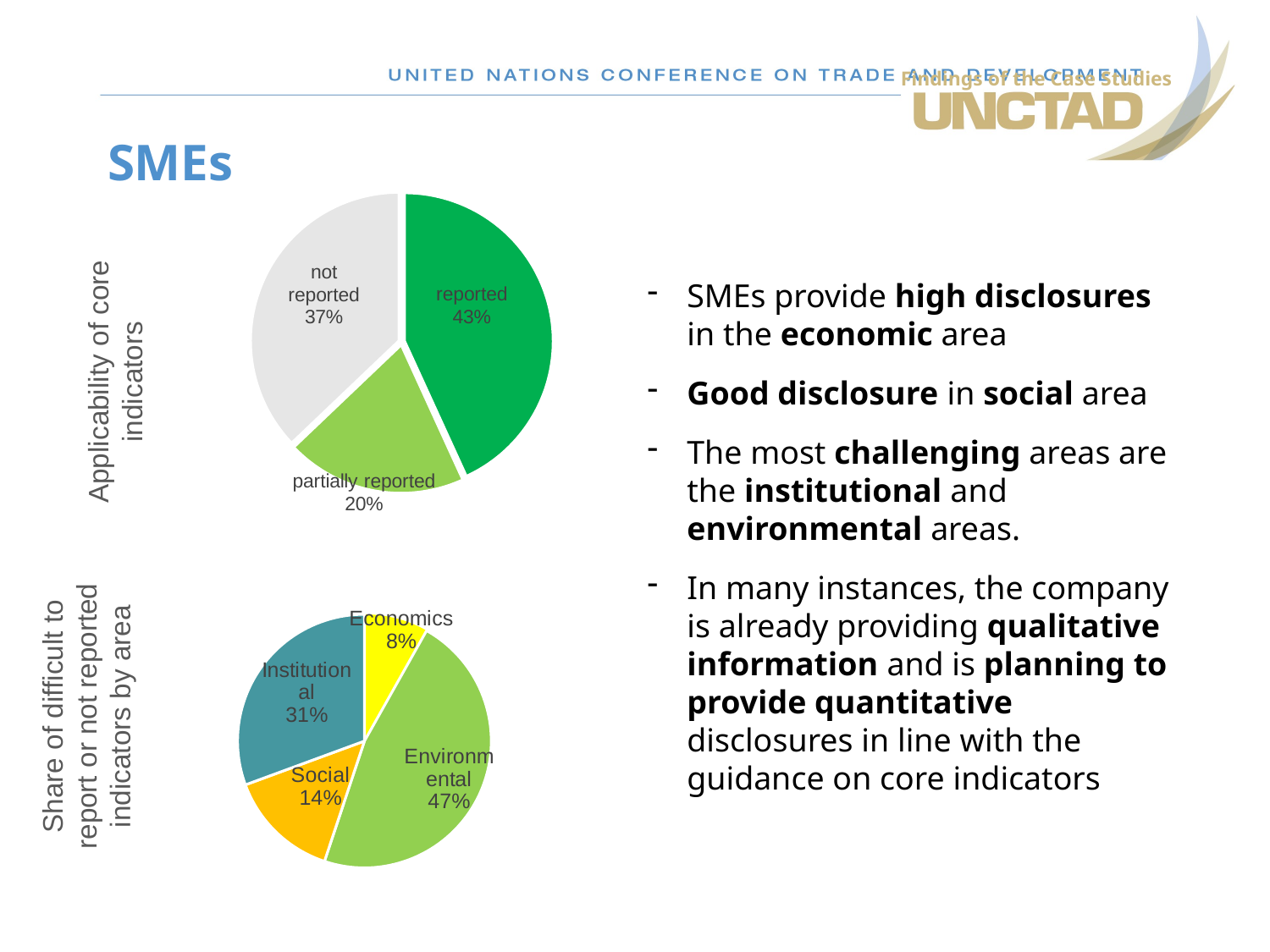
In the top pie chart (Applicability of core indicators), what share is 'partially reported'? 20% In the top pie chart (Applicability of core indicators), what share is 'not reported'? 37% What type of chart is the top chart (Applicability of core indicators)? Pie chart In the top pie chart (Applicability of core indicators), which category has the largest share? reported In the top pie chart (Applicability of core indicators), what share is 'reported'? 43% In the bottom pie chart (Share of difficult to report or not reported indicators by area), what share is Environmental? 47% How many slices does the bottom pie chart (Share of difficult to report or not reported indicators by area) have? 4 In the top pie chart (Applicability of core indicators), which category has the smallest share? partially reported In the bottom pie chart (Share of difficult to report or not reported indicators by area), which is larger, Social or Institutional? Institutional In the top pie chart (Applicability of core indicators), what is the difference between the 'reported' and 'not reported' shares? 6% In the bottom pie chart (Share of difficult to report or not reported indicators by area), what share is Institutional? 31% In the bottom pie chart (Share of difficult to report or not reported indicators by area), which area has the smallest share? Economics